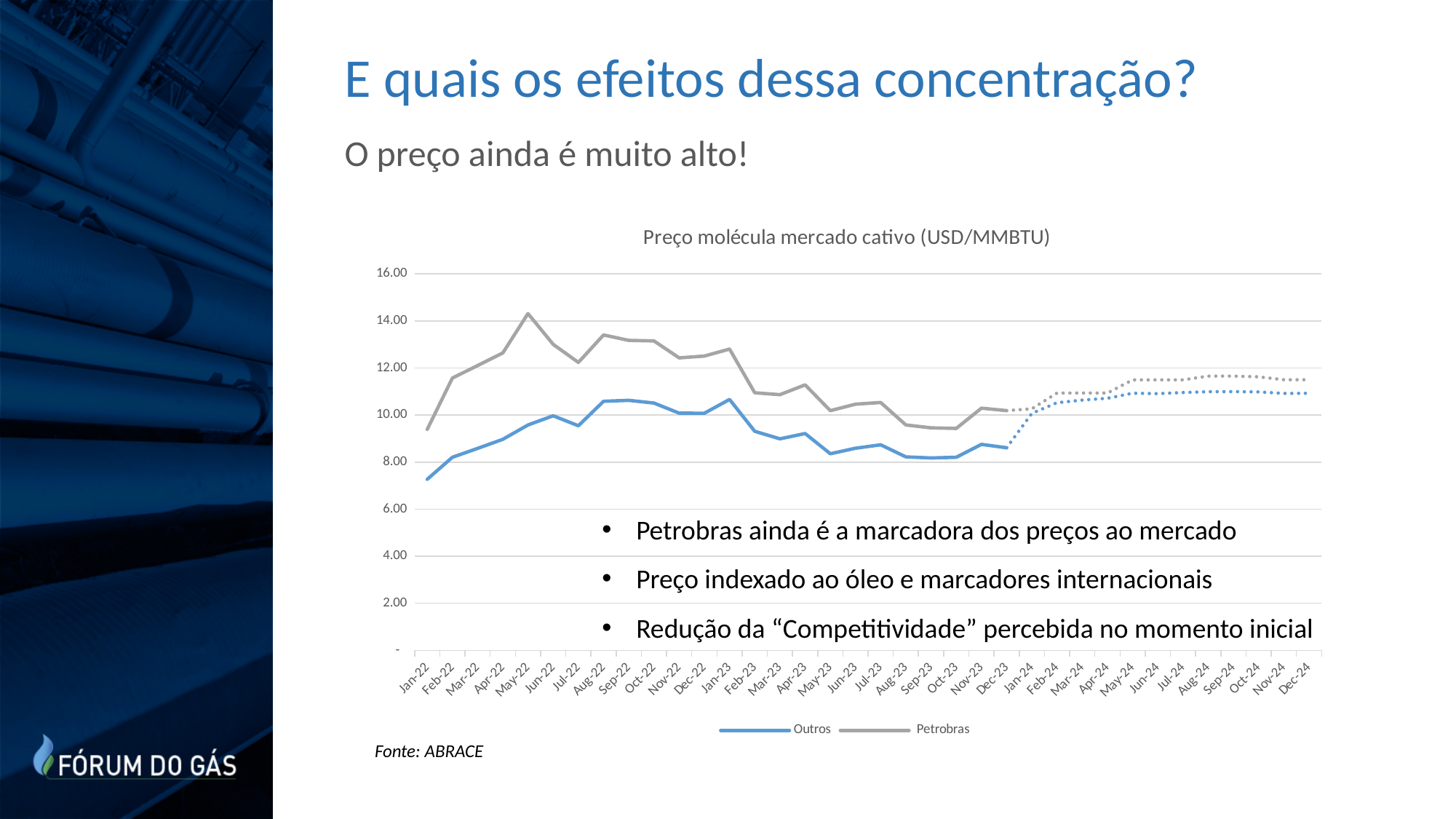
What kind of chart is shown on the slide? line chart How many months are shown on the x axis of the chart? 36 How many series does the legend of the chart list? 2 Does the Outros series rise or fall from Jan-22 to Aug-22? rise Is the value for Petrobras in May-22 greater or less than 12.00? greater In which month does the Petrobras series reach its highest value? May-22 Is the value for Outros in Jan-22 greater or less than 8.00? less What is the title of the chart? Preço molécula mercado cativo (USD/MMBTU) Which series has the higher value in Jan-23, Outros or Petrobras? Petrobras In which month is the Outros series at its lowest value? Jan-22 What are the names of the two series in the chart's legend? Outros and Petrobras Is the value for Petrobras in Dec-24 greater or less than 12.00? less